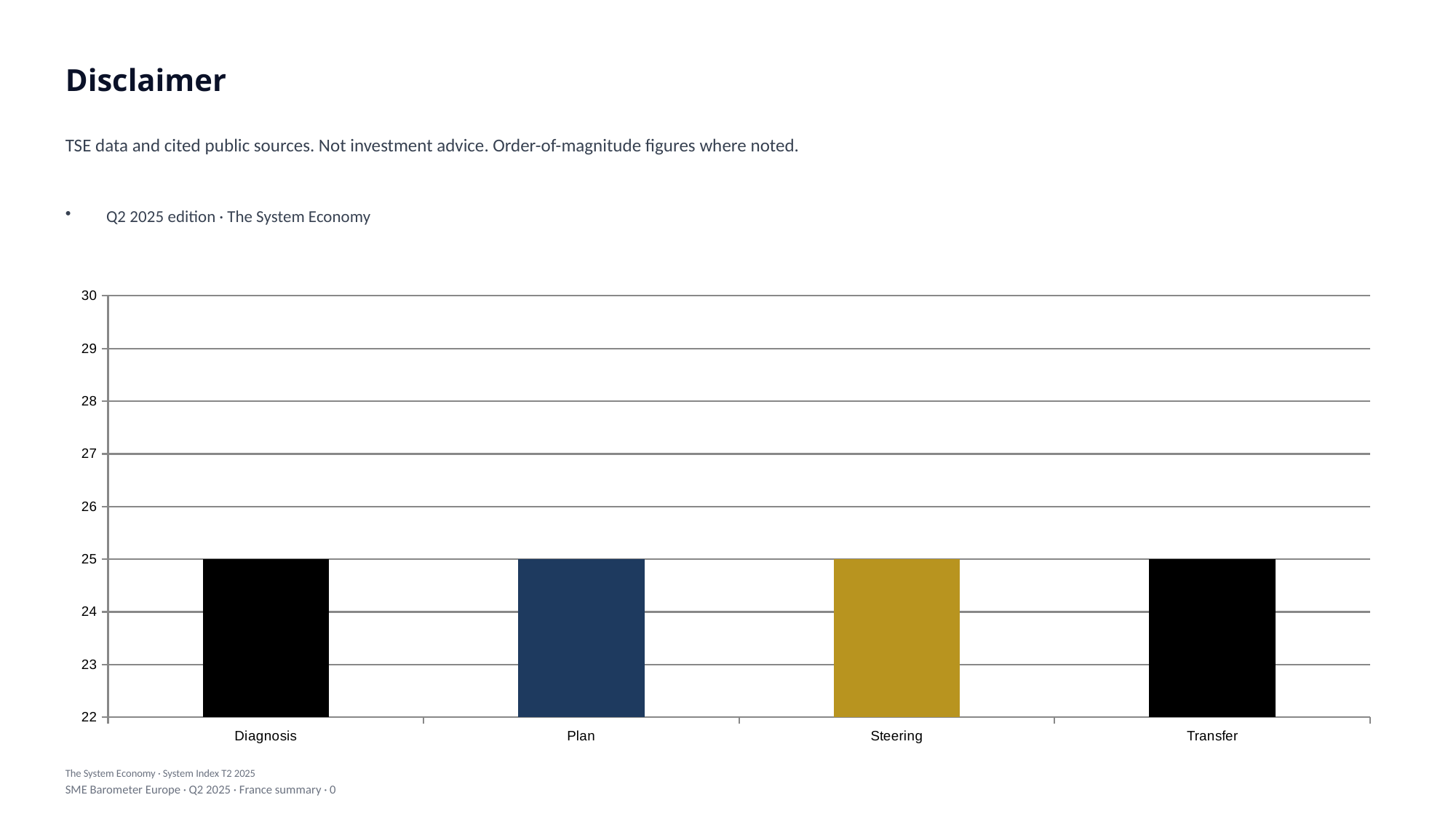
What is the value for Plan? 25 How many categories are shown on the x axis? 4 What is the highest value shown on the vertical axis? 30 What kind of chart is shown on the slide? bar chart What is the value for Transfer? 25 Is the value for Diagnosis greater or less than 23? greater What is the value for Steering? 25 What colour is the bar for Steering? gold What is the difference between the values for Plan and Steering? 0 Is the value for Transfer greater or less than 28? less What is the value for Diagnosis? 25 Do the values rise, fall or stay flat from Diagnosis to Transfer? stay flat